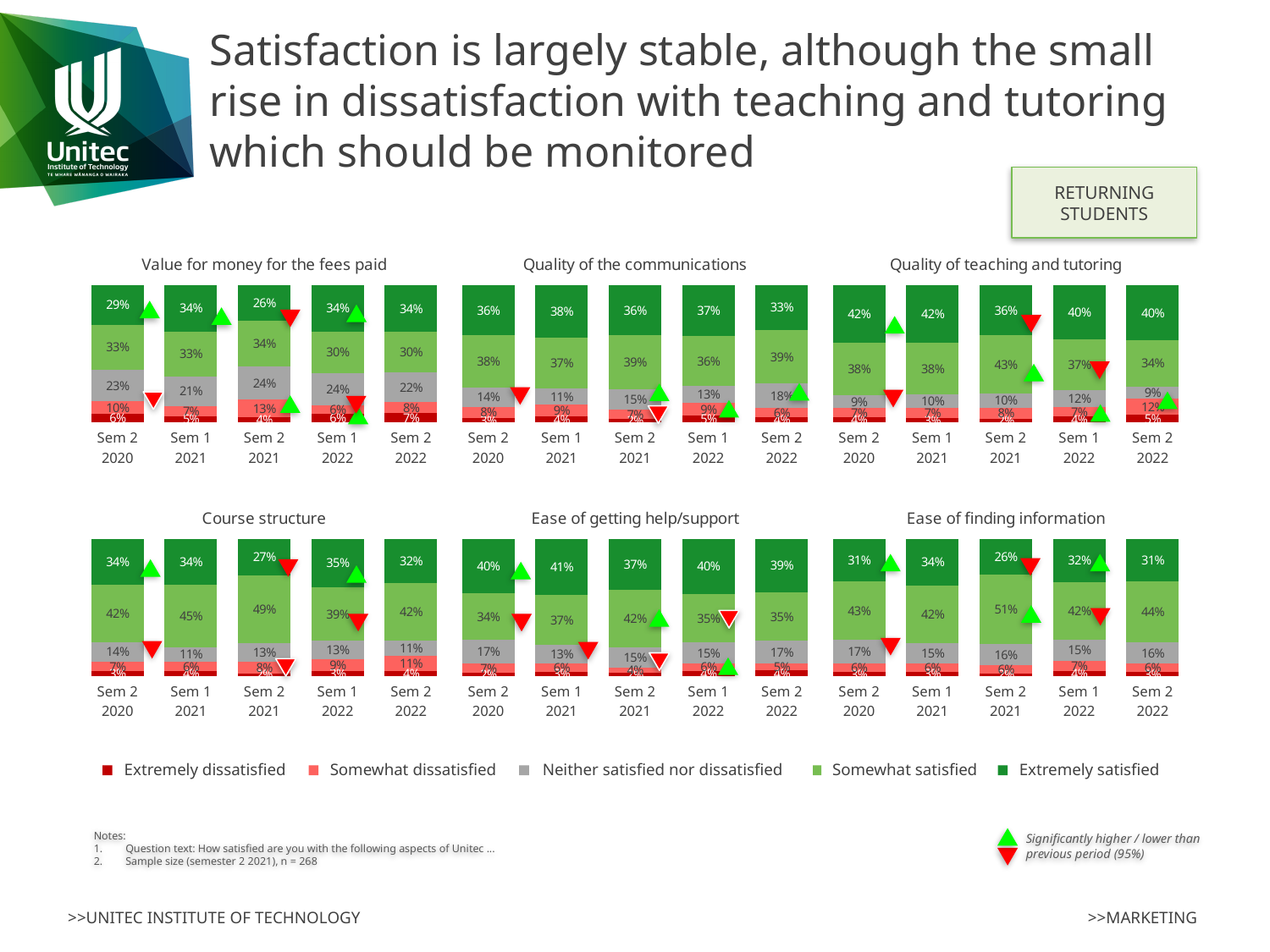
What kind of chart is used for 'Course structure'? Stacked bar chart In the 'Quality of the communications' chart, what is the Neither satisfied nor dissatisfied value for Sem 2 2022? 18% In the 'Quality of teaching and tutoring' chart, which period has the highest Somewhat satisfied value? Sem 2 2021 In the 'Course structure' chart, what is the difference between the Somewhat satisfied values for Sem 2 2021 and Sem 1 2022? 10% In the 'Ease of getting help/support' chart, is the Extremely satisfied value for Sem 1 2021 larger than the value for Sem 2 2021? Yes, Sem 1 2021 (41%) is larger than Sem 2 2021 (37%) In the 'Quality of teaching and tutoring' chart, what is the Somewhat dissatisfied value for Sem 2 2022? 12% In the 'Ease of finding information' chart, what is the Somewhat satisfied value for Sem 2 2021? 51% In the 'Value for money for the fees paid' chart, what is the Extremely satisfied value for Sem 2 2021? 26% In the 'Ease of finding information' chart, what is the difference between the Extremely satisfied values for Sem 1 2021 and Sem 2 2021? 8% How many periods are shown on the x axis of the 'Quality of the communications' chart? 5 How many series does the legend list? 5 In the 'Course structure' chart, which period has the lowest Extremely satisfied value? Sem 2 2021